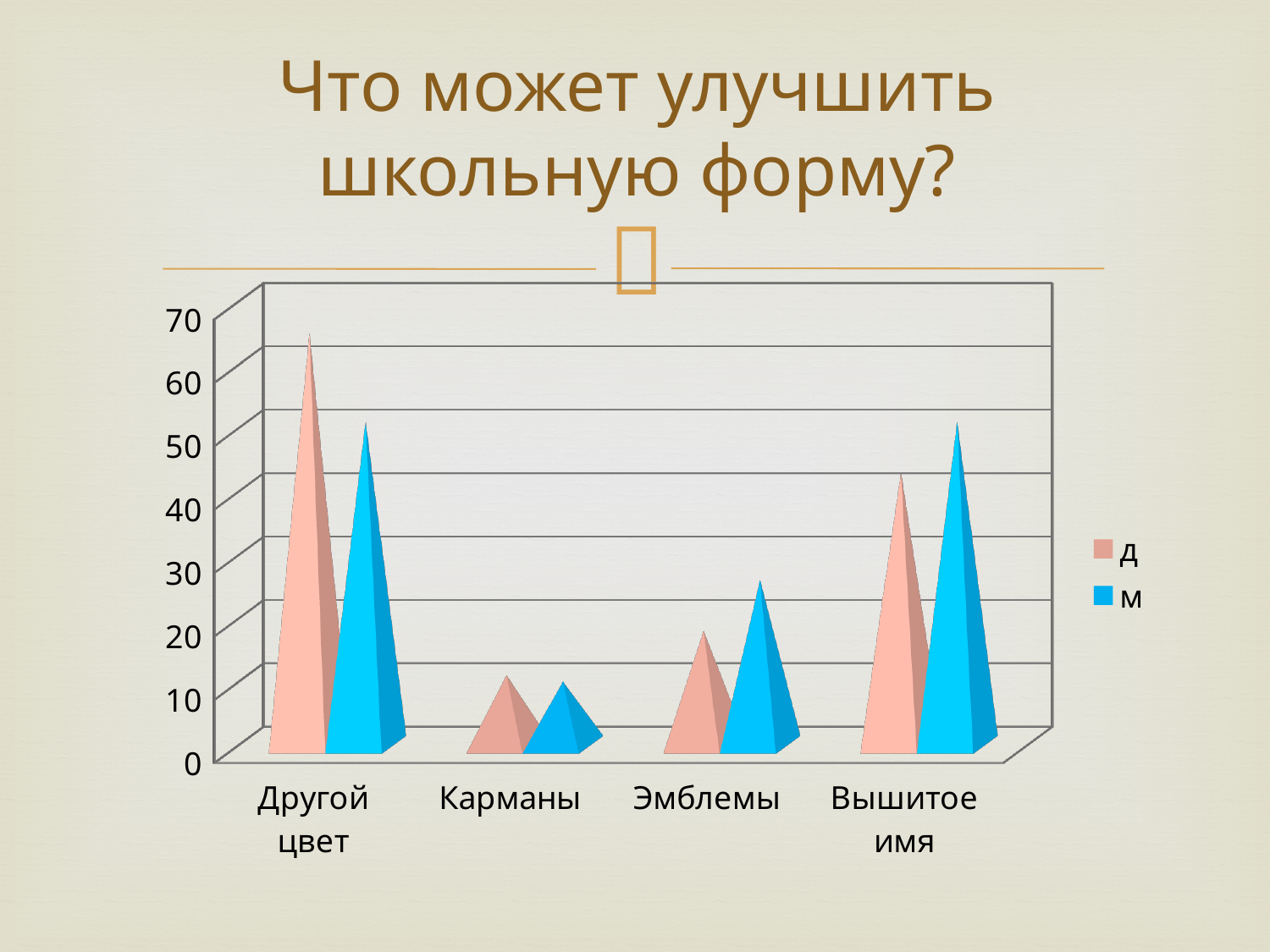
Is the value for м in the category Вышитое имя greater or less than 40? greater Which category has the lowest value for the series м? Карманы For the category Другой цвет, which series has the larger value, д or м? д Is the value for д in the category Другой цвет greater or less than 50? greater Which category has the highest value for the series д? Другой цвет How many series does the legend list? 2 How many categories are shown on the x axis? 4 Which category has the lowest value for the series д? Карманы What kind of chart is shown on the slide? bar chart What are the two entries listed in the legend? д and м For the category Эмблемы, which series has the larger value, д or м? м Is the value for д in the category Карманы greater or less than 20? less